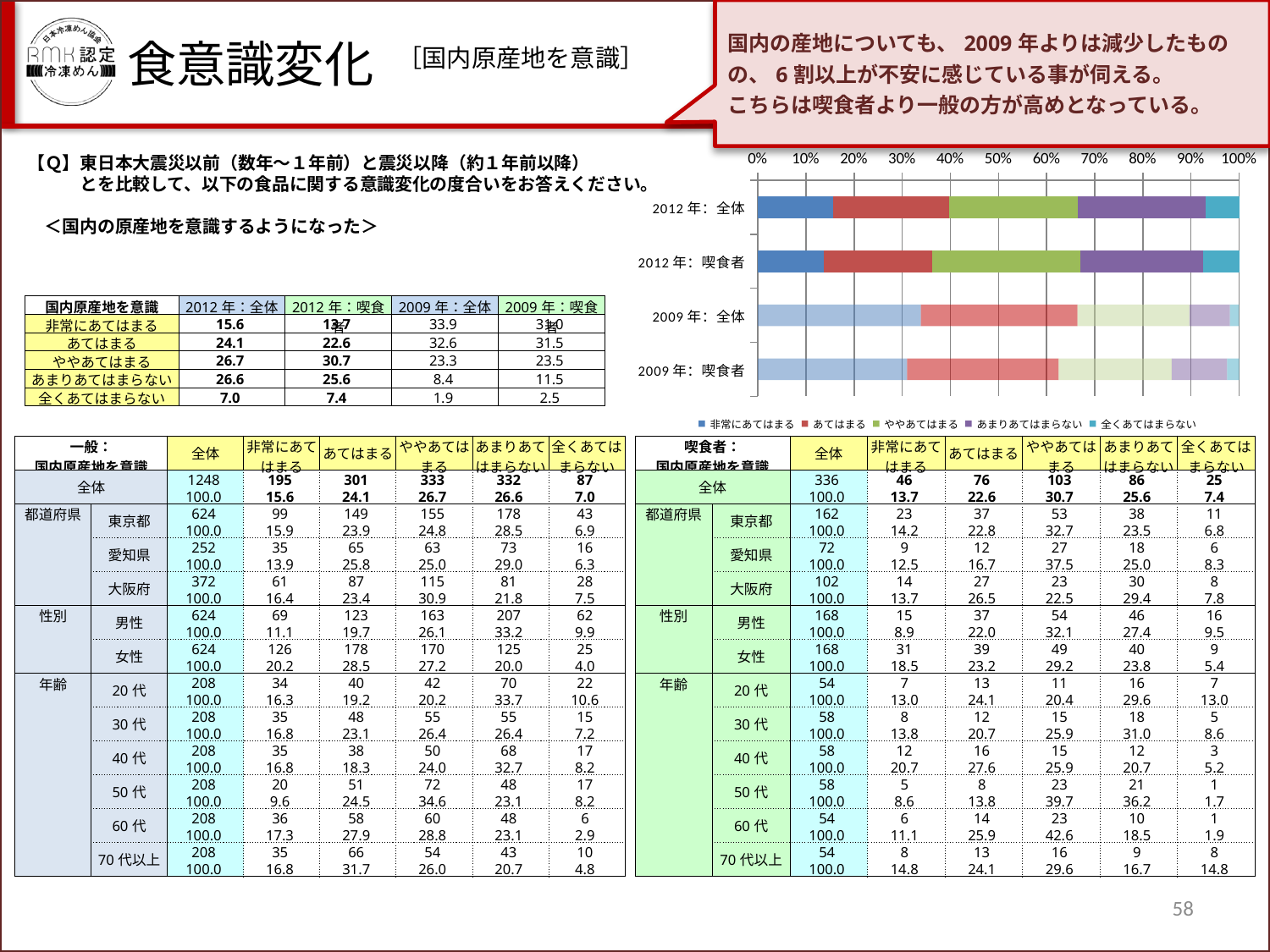
How many bars (categories) does the chart show? 4 Is the 非常にあてはまる segment for 2012年：全体 greater or less than 20%? less Is the 非常にあてはまる segment for 2012年：喫食者 greater or less than 20%? less Which bar has the larger 非常にあてはまる segment, 2009年：全体 or 2012年：全体? 2009年：全体 How many series does the chart legend list? 5 Is the 非常にあてはまる segment for 2009年：全体 greater or less than 30%? greater What is the highest value shown on the chart's horizontal axis? 100% Which bar has the larger 全くあてはまらない segment, 2012年：喫食者 or 2009年：喫食者? 2012年：喫食者 Which bar has the larger あまりあてはまらない segment, 2012年：全体 or 2009年：全体? 2012年：全体 Which category is plotted in the topmost bar of the chart? 2012年：全体 What kind of chart is shown on the slide? stacked bar chart